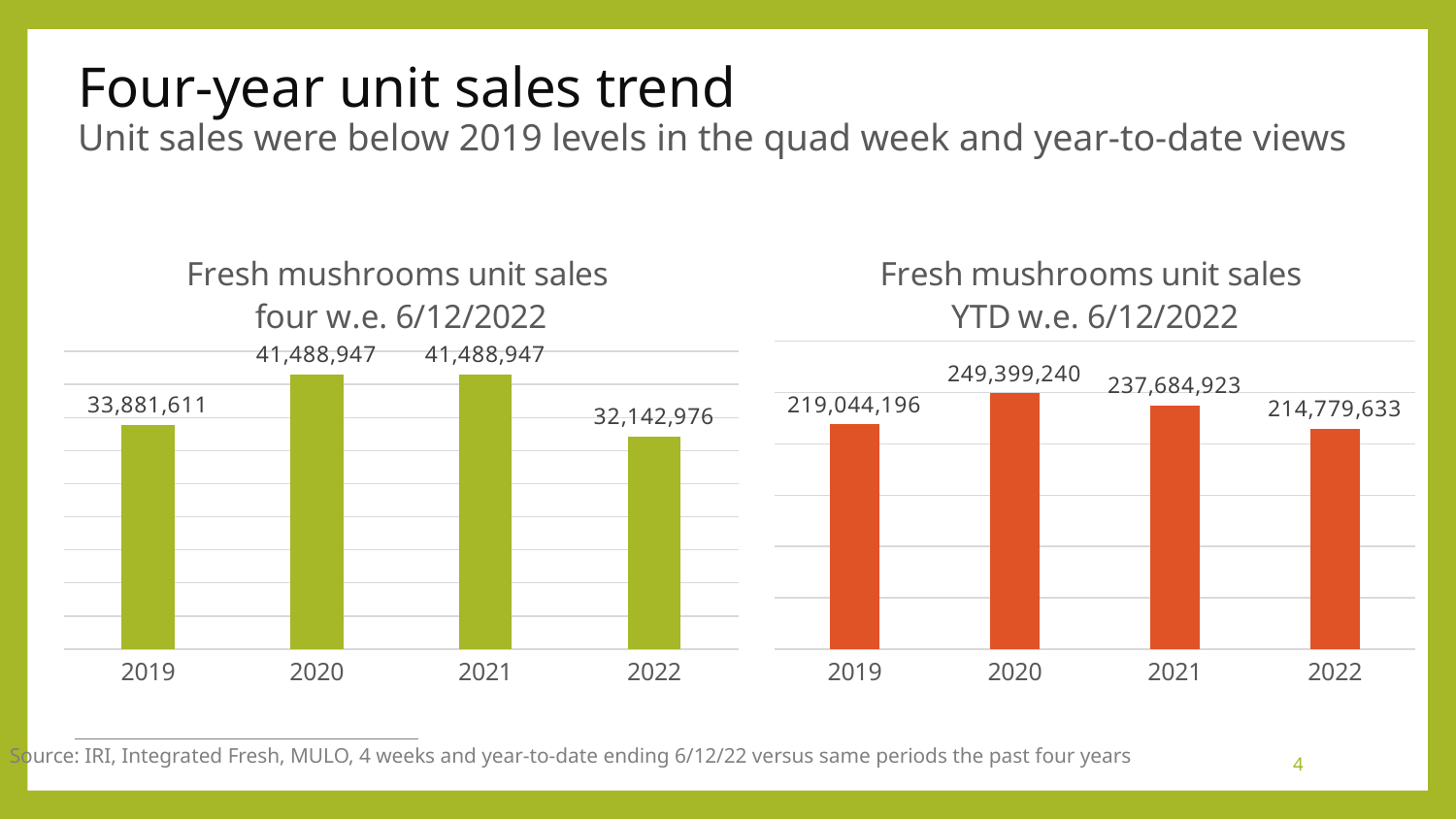
In the 'Fresh mushrooms unit sales four w.e. 6/12/2022' chart, which year has the lowest value? 2022 In the 'Fresh mushrooms unit sales four w.e. 6/12/2022' chart, what is the difference between the 2019 and 2022 values? 1,738,635 In the 'Fresh mushrooms unit sales YTD w.e. 6/12/2022' chart, what is the difference between the 2020 and 2019 values? 30,355,044 In the 'Fresh mushrooms unit sales four w.e. 6/12/2022' chart, what is the value for 2022? 32,142,976 In the 'Fresh mushrooms unit sales YTD w.e. 6/12/2022' chart, what is the value for 2022? 214,779,633 What type of chart is the 'Fresh mushrooms unit sales YTD w.e. 6/12/2022' chart? Bar chart In the 'Fresh mushrooms unit sales YTD w.e. 6/12/2022' chart, which is larger, the value for 2019 or the value for 2021? 2021 In the 'Fresh mushrooms unit sales YTD w.e. 6/12/2022' chart, which year has the highest value? 2020 In the 'Fresh mushrooms unit sales YTD w.e. 6/12/2022' chart, which year has the lowest value? 2022 How many years are shown on the x axis of the 'Fresh mushrooms unit sales four w.e. 6/12/2022' chart? 4 In the 'Fresh mushrooms unit sales YTD w.e. 6/12/2022' chart, what is the value for 2021? 237,684,923 In the 'Fresh mushrooms unit sales four w.e. 6/12/2022' chart, what is the value for 2019? 33,881,611